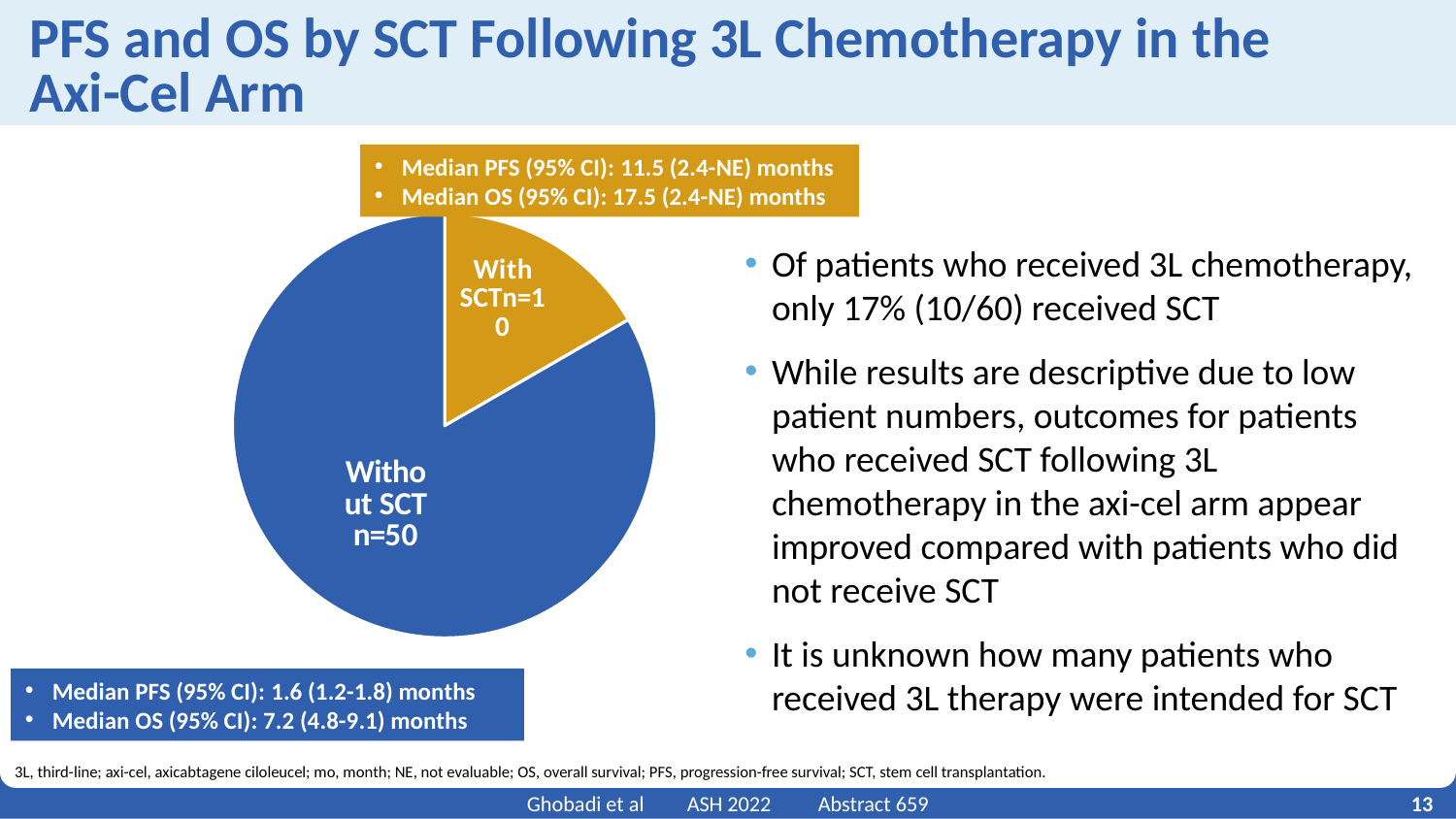
What is the total number of patients represented in the pie chart? 60 What share of the pie chart does the 'With SCT' slice represent? 17% Which group represents the smallest slice of the pie chart? With SCT What is the median OS reported for the 'Without SCT' group in the annotation below the pie chart? 7.2 (4.8-9.1) months What is the median PFS reported for the 'With SCT' group in the annotation above the pie chart? 11.5 (2.4-NE) months Which slice of the pie chart is larger, 'With SCT' or 'Without SCT'? Without SCT What kind of chart is shown on the slide? pie chart How many slices does the pie chart have? 2 What colour is the 'Without SCT' slice of the pie chart? blue What is the difference in patient numbers between the 'Without SCT' and 'With SCT' slices? 40 How many patients are in the 'With SCT' slice of the pie chart? n=10 How many patients are in the 'Without SCT' slice of the pie chart? n=50